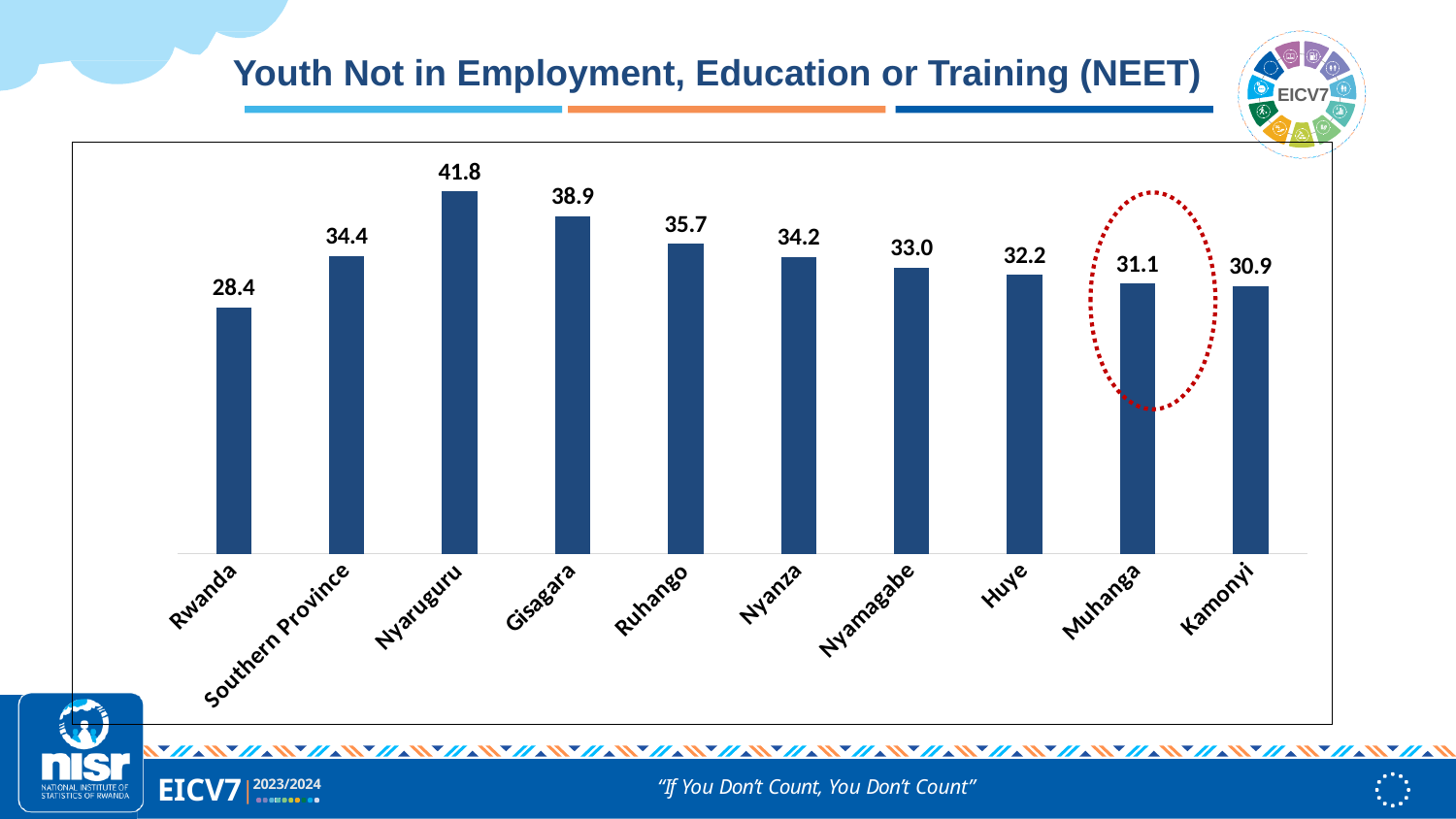
Which is larger, the value for Southern Province or the value for Kamonyi? Southern Province How many categories are shown on the chart? 10 What kind of chart is shown on the slide? Bar chart What is the value for Muhanga? 31.1 What is the value for Rwanda? 28.4 Which category is highlighted with a red dotted circle? Muhanga Which category has the highest value? Nyaruguru Which category has the lowest value? Rwanda What is the difference between the values for Nyaruguru and Rwanda? 13.4 What is the difference between the values for Gisagara and Huye? 6.7 Which is larger, the value for Ruhango or the value for Nyamagabe? Ruhango What is the value for Nyaruguru? 41.8